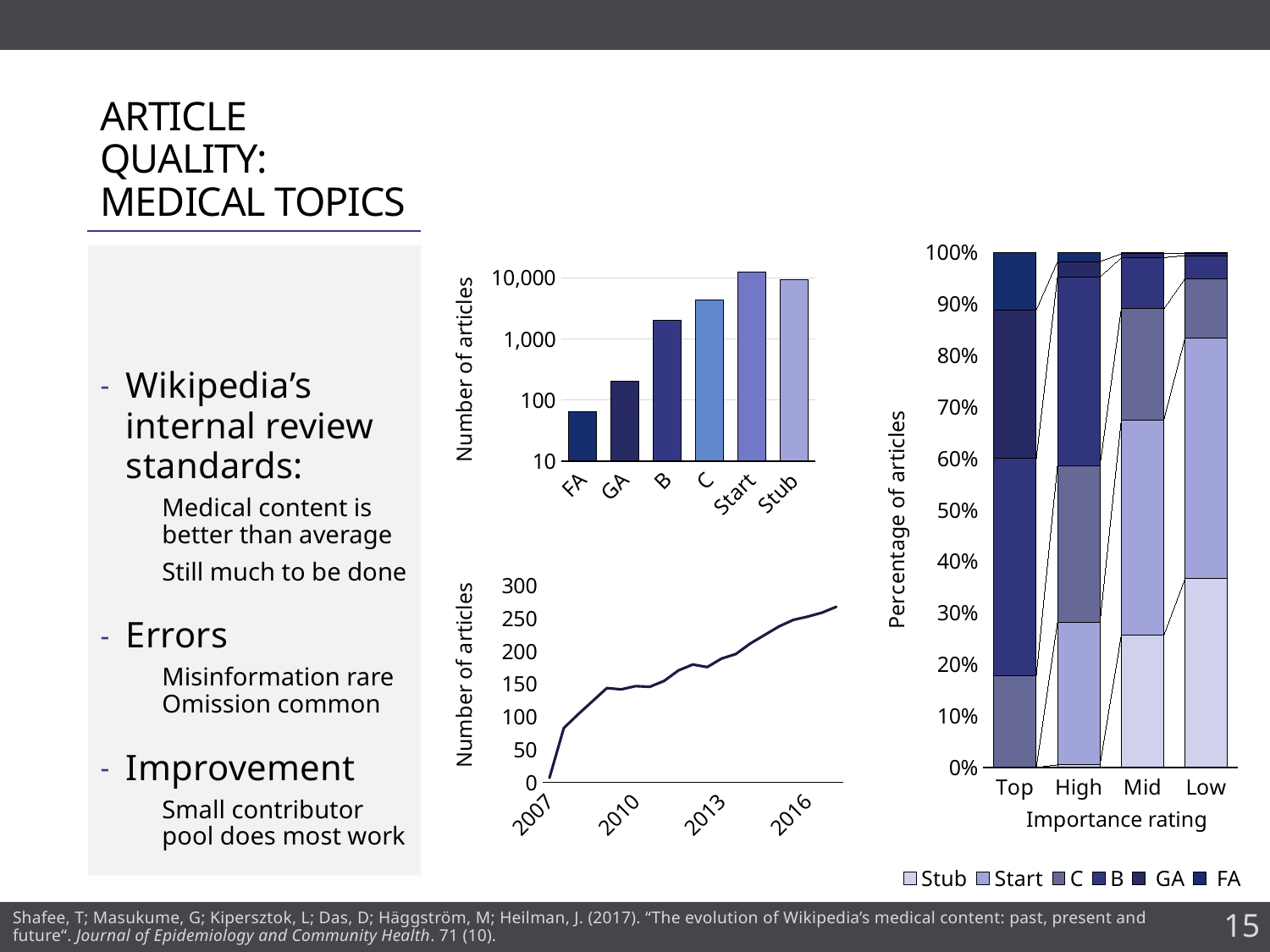
In the top-middle bar chart of number of articles by quality class, is the value for B greater or less than 1,000? greater In the right-hand stacked bar chart of percentage of articles by importance rating, how many series does the legend list? 6 In the top-middle bar chart of number of articles by quality class, which category has the lowest value? FA What kind of chart is the bottom-middle chart showing number of articles from 2007 to 2016? line chart In the top-middle bar chart of number of articles by quality class, is the value for FA greater or less than 100? less In the top-middle bar chart of number of articles by quality class, which category has the highest value? Start In the right-hand stacked bar chart of percentage of articles by importance rating, is the Stub share for Low greater or less than 30%? greater In the top-middle bar chart of number of articles by quality class, which is larger, the value for GA or the value for C? C In the top-middle bar chart of number of articles by quality class, how many categories are shown on the x axis? 6 In the bottom-middle line chart, do the values rise or fall from 2007 to 2016? rise